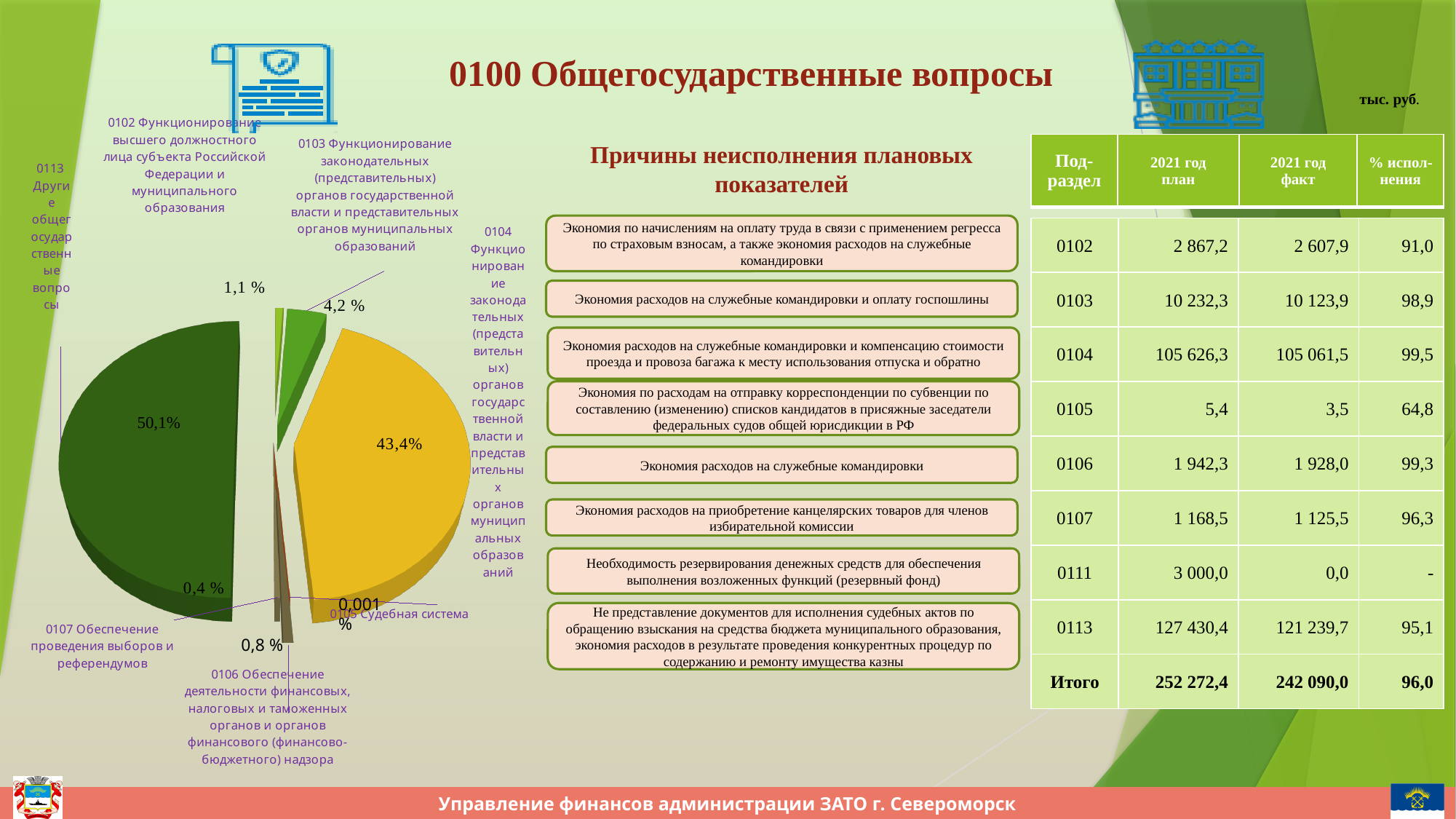
Which subsection has the largest slice in the pie chart? 0113 Другие общегосударственные вопросы What is the difference in percentage points between the shares of 0113 and 0104 in the pie chart? 6,7 What share of the pie chart does subsection 0106 have? 0,8 % What kind of chart is shown on the left of the slide? pie chart How many slices does the pie chart have? 7 What share of the pie chart does subsection 0104 have? 43,4% In the pie chart, which is larger: the share of 0113 or the share of 0104? 0113 What share of the pie chart does subsection 0105 (Судебная система) have? 0,001 % Which subsection has the smallest slice in the pie chart? 0105 Судебная система